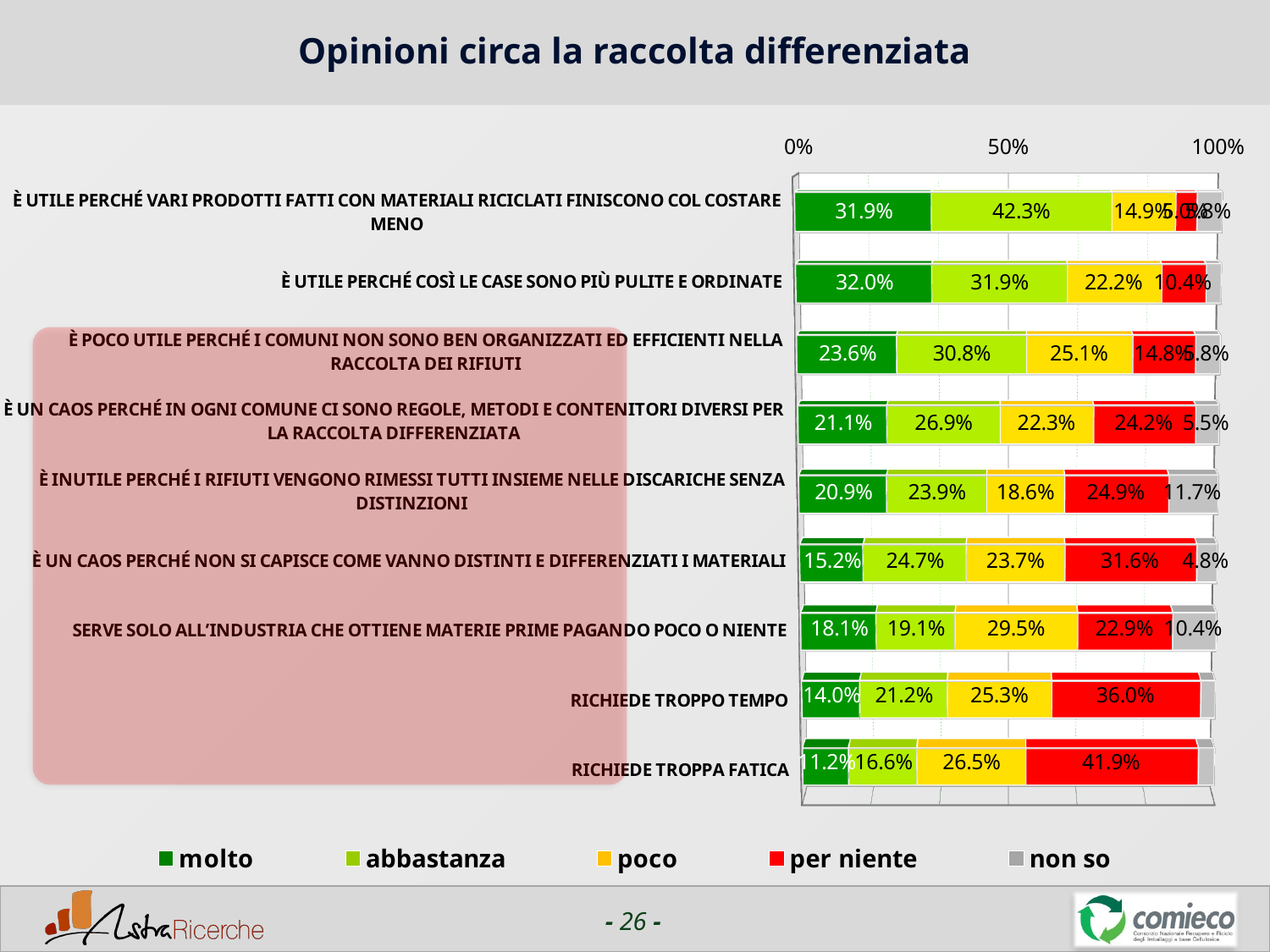
What is the 'molto' value for 'È UTILE PERCHÉ COSÌ LE CASE SONO PIÙ PULITE E ORDINATE'? 32.0% What is the 'poco' value for 'SERVE SOLO ALL'INDUSTRIA CHE OTTIENE MATERIE PRIME PAGANDO POCO O NIENTE'? 29.5% Which statement has the highest 'per niente' value? RICHIEDE TROPPA FATICA Which statement has the lowest 'molto' value? RICHIEDE TROPPA FATICA How many series does the legend list? 5 How many statements (categories) are plotted in the chart? 9 Which is larger: the 'abbastanza' value for 'È POCO UTILE PERCHÉ I COMUNI NON SONO BEN ORGANIZZATI ED EFFICIENTI NELLA RACCOLTA DEI RIFIUTI' or the 'abbastanza' value for 'È INUTILE PERCHÉ I RIFIUTI VENGONO RIMESSI TUTTI INSIEME NELLE DISCARICHE SENZA DISTINZIONI'? È POCO UTILE PERCHÉ I COMUNI NON SONO BEN ORGANIZZATI ED EFFICIENTI NELLA RACCOLTA DEI RIFIUTI What kind of chart is shown on the slide? Stacked bar chart Which colour represents the 'per niente' series in the legend? Red What is the 'abbastanza' value for 'È UTILE PERCHÉ VARI PRODOTTI FATTI CON MATERIALI RICICLATI FINISCONO COL COSTARE MENO'? 42.3% What is the 'per niente' value for 'RICHIEDE TROPPO TEMPO'? 36.0% What is the difference between the 'per niente' values for 'RICHIEDE TROPPA FATICA' and 'RICHIEDE TROPPO TEMPO'? 5.9%